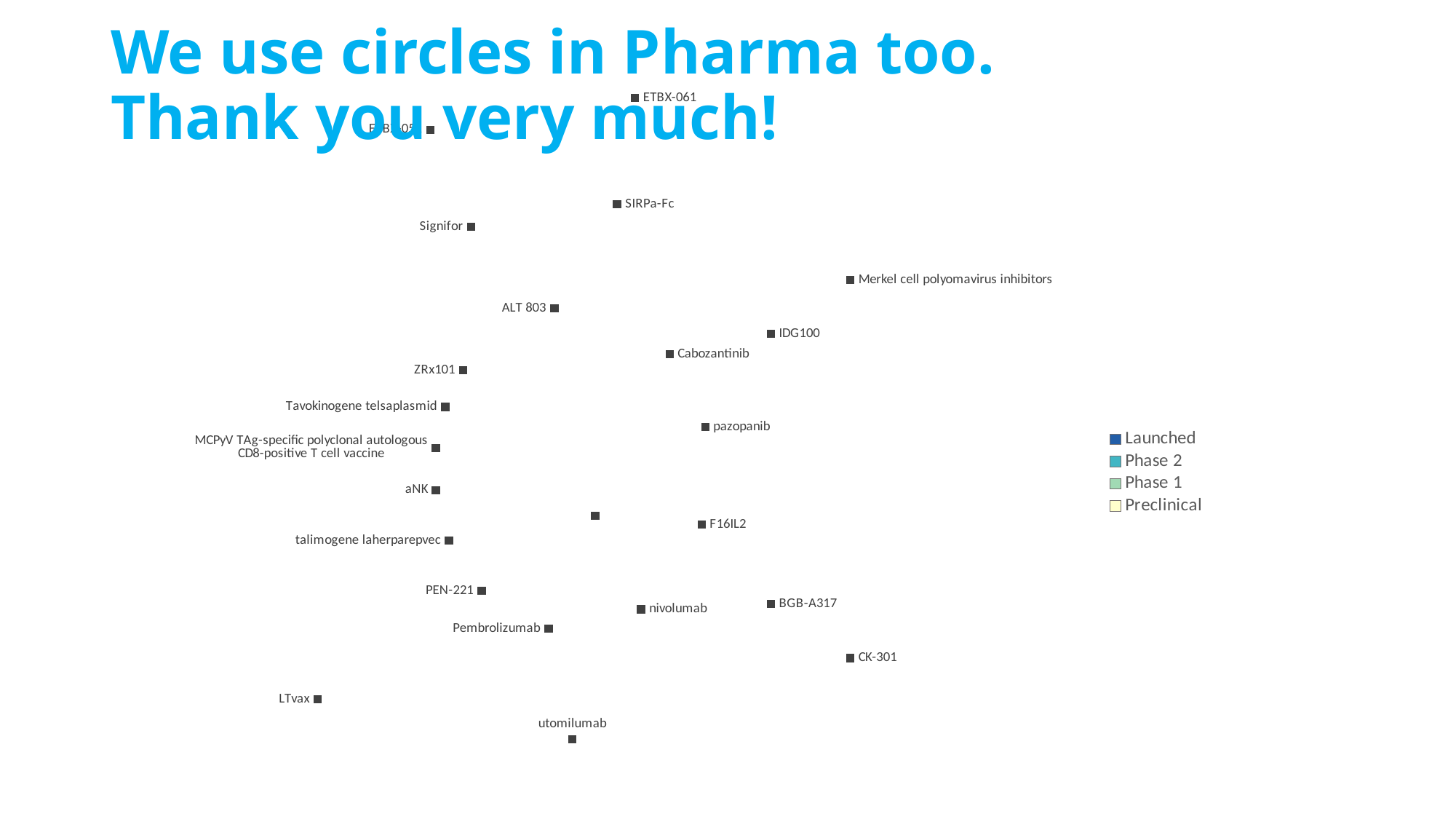
Which labelled point is plotted lowest on the chart? utomilumab Which labelled point is plotted highest on the chart? ETBX-061 Is the point for CK-301 plotted to the right or to the left of the point for BGB-A317? right Which legend entry is listed first in the chart's legend? Launched Which legend entry is listed last in the chart's legend? Preclinical Is the point for SIRPa-Fc plotted higher or lower than the point for Signifor? higher How many entries does the chart's legend list? 4 Is the point for IDG100 plotted higher or lower than the point for Cabozantinib? higher What kind of chart is shown on the slide? scatter chart Which labelled point is plotted furthest to the left on the chart? LTvax